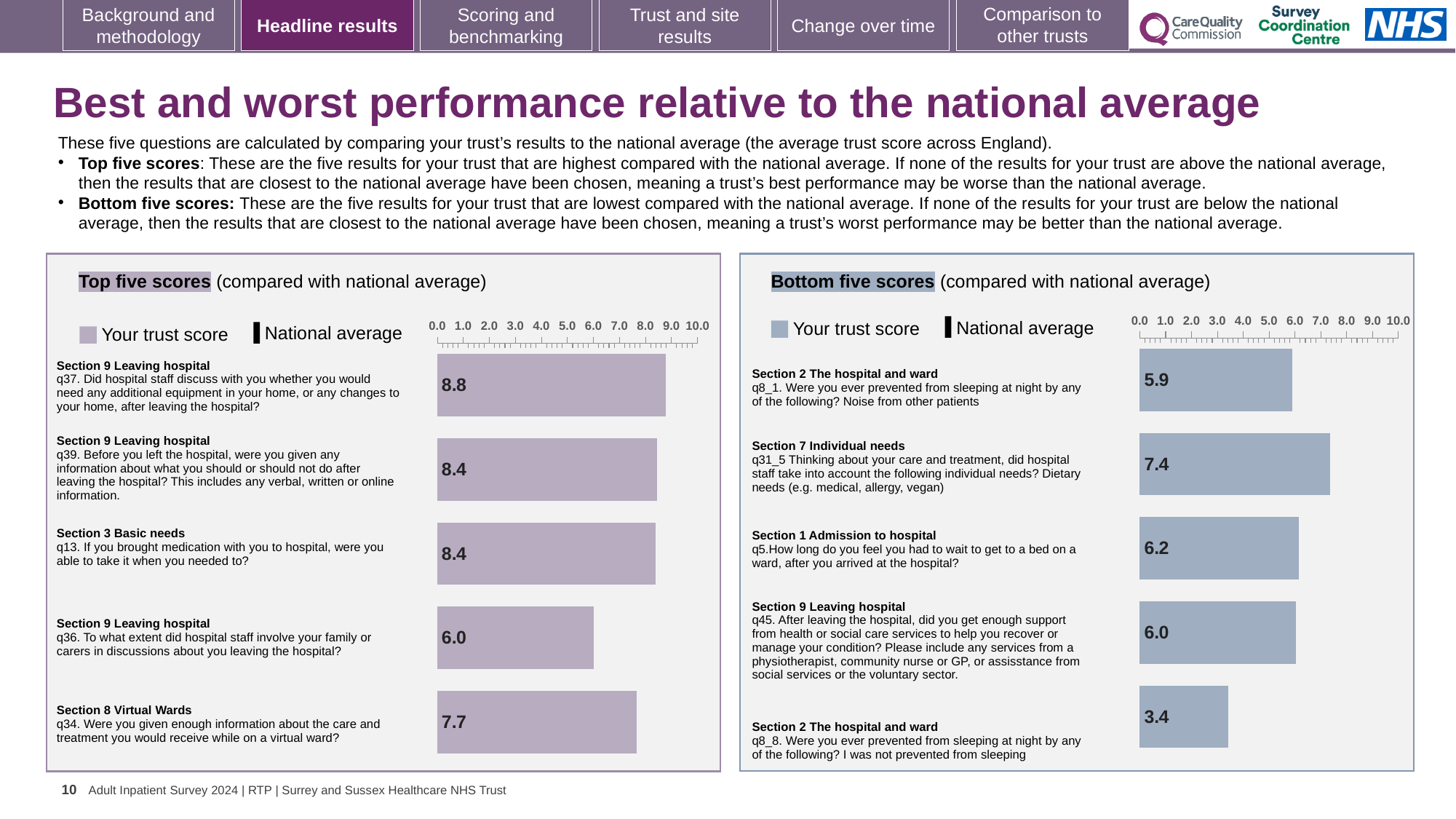
In the Bottom five scores chart, what is the trust score for q31_5 (Dietary needs)? 7.4 In the Bottom five scores chart, which is larger, the trust score for q5 or for q45? q5 In the Top five scores chart, what is the trust score for q37 (Did hospital staff discuss with you whether you would need any additional equipment in your home)? 8.8 In the Bottom five scores chart, what is the difference between the trust scores for q31_5 and q8_8? 4.0 In the Top five scores chart, what is the difference between the trust scores for q37 and q36? 2.8 In the Bottom five scores chart, which question has the lowest trust score? q8_8 In the Top five scores chart, which question has the highest trust score? q37 In the Top five scores chart, what is the trust score for q36 (To what extent did hospital staff involve your family or carers in discussions about you leaving the hospital)? 6.0 How many questions are shown in the Bottom five scores chart? 5 In the Top five scores chart, what is the trust score for q34 (Were you given enough information about the care and treatment you would receive while on a virtual ward)? 7.7 In the Bottom five scores chart, what is the trust score for q8_1 (Noise from other patients)? 5.9 What type of chart is the Top five scores chart? Bar chart